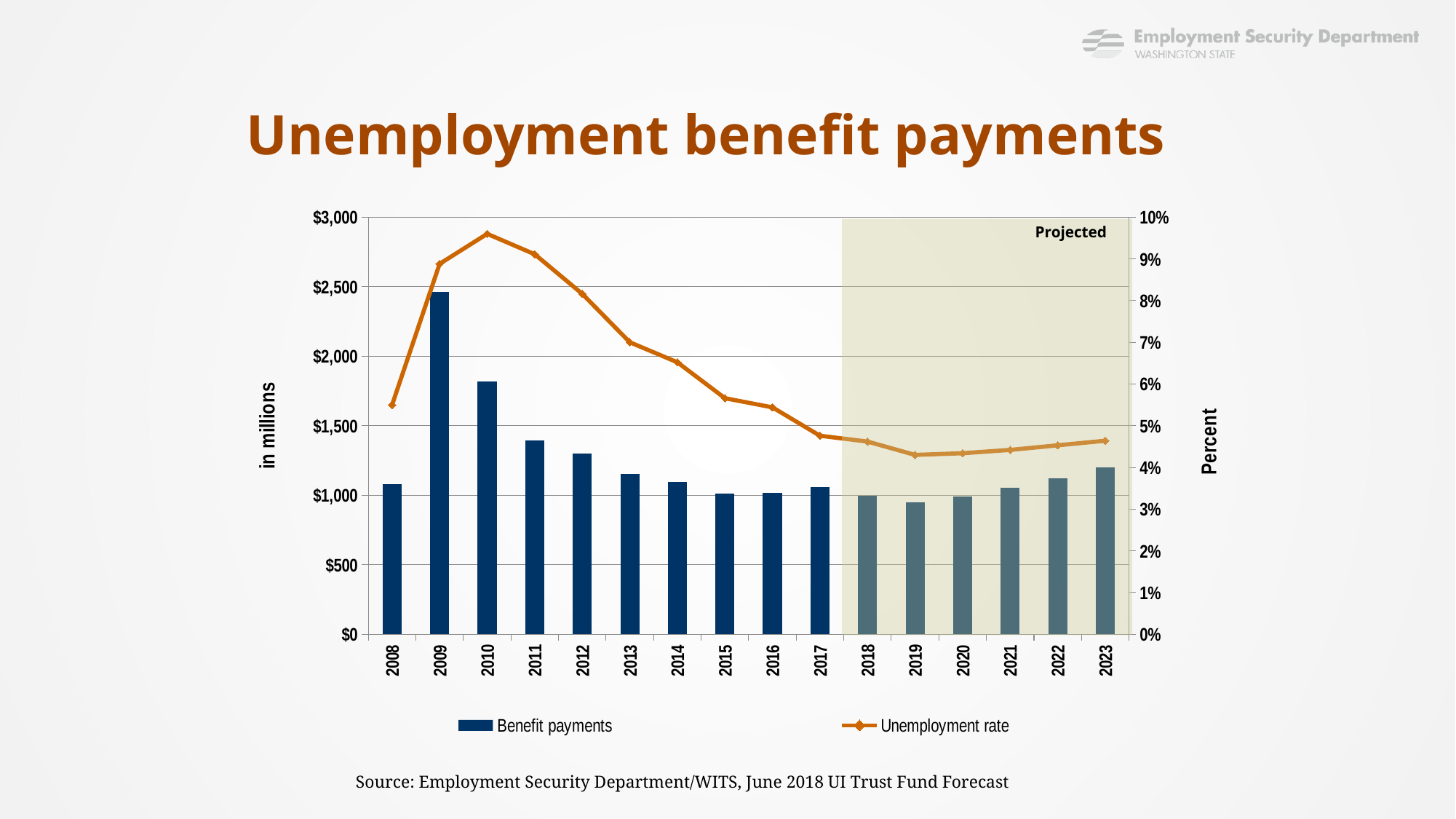
Which year has the highest benefit payments? 2009 What label is shown in the shaded area covering 2018 to 2023? Projected Is the unemployment rate for 2013 greater or less than 8%? less In which year does the unemployment rate peak? 2010 Which year has the lowest benefit payments? 2019 How many years are shown on the x axis? 16 Are benefit payments for 2019 greater or less than $1,000 million? less Does the unemployment rate rise or fall from 2010 to 2017? fall What kind of chart is used to show benefit payments on this slide? bar chart How many series does the legend list? 2 Are benefit payments for 2009 greater or less than $2,000 million? greater Which year has higher benefit payments, 2010 or 2011? 2010